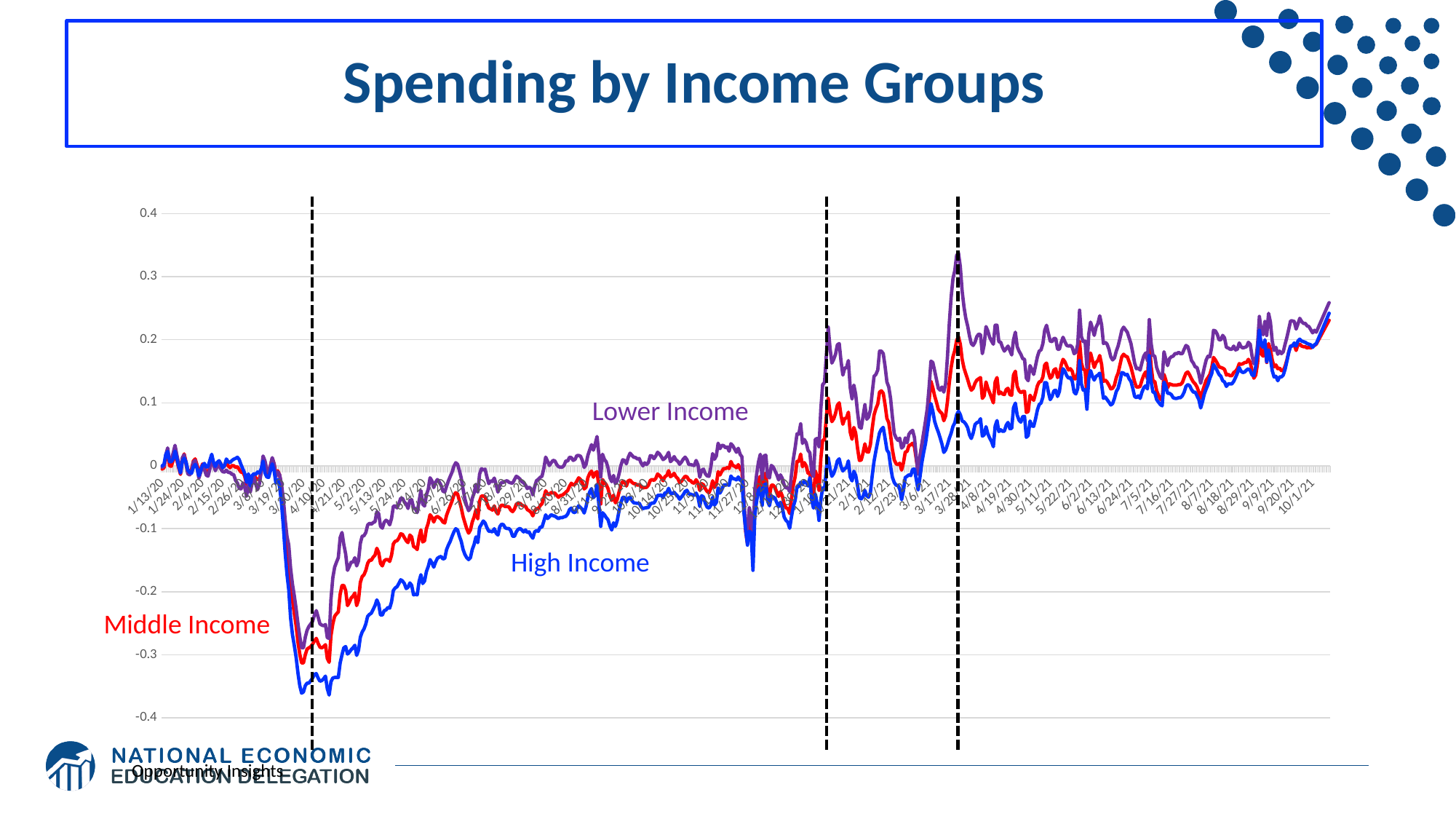
Around 8/2020, which is higher: the Lower Income line or the High Income line? Lower Income Is the lowest value of the High Income line in spring 2020 greater or less than -0.3? less How many income-group series are plotted on the chart? 3 Which income group reaches the highest value at the peak near 3/28/21? Lower Income What is the title of the chart slide? Spending by Income Groups Do the three lines rise or fall between 3/19/20 and 4/10/20? Fall What kind of chart is shown on the slide? Line chart Which income group has the lowest value at the trough in spring 2020? High Income Is the lowest value of the Lower Income line in spring 2020 greater or less than -0.3? greater Is the peak value of the Lower Income line near 3/28/21 greater or less than 0.3? greater Which colour is used for the High Income line? Blue Do the three lines generally rise or fall from 4/2020 through 9/2020? Rise